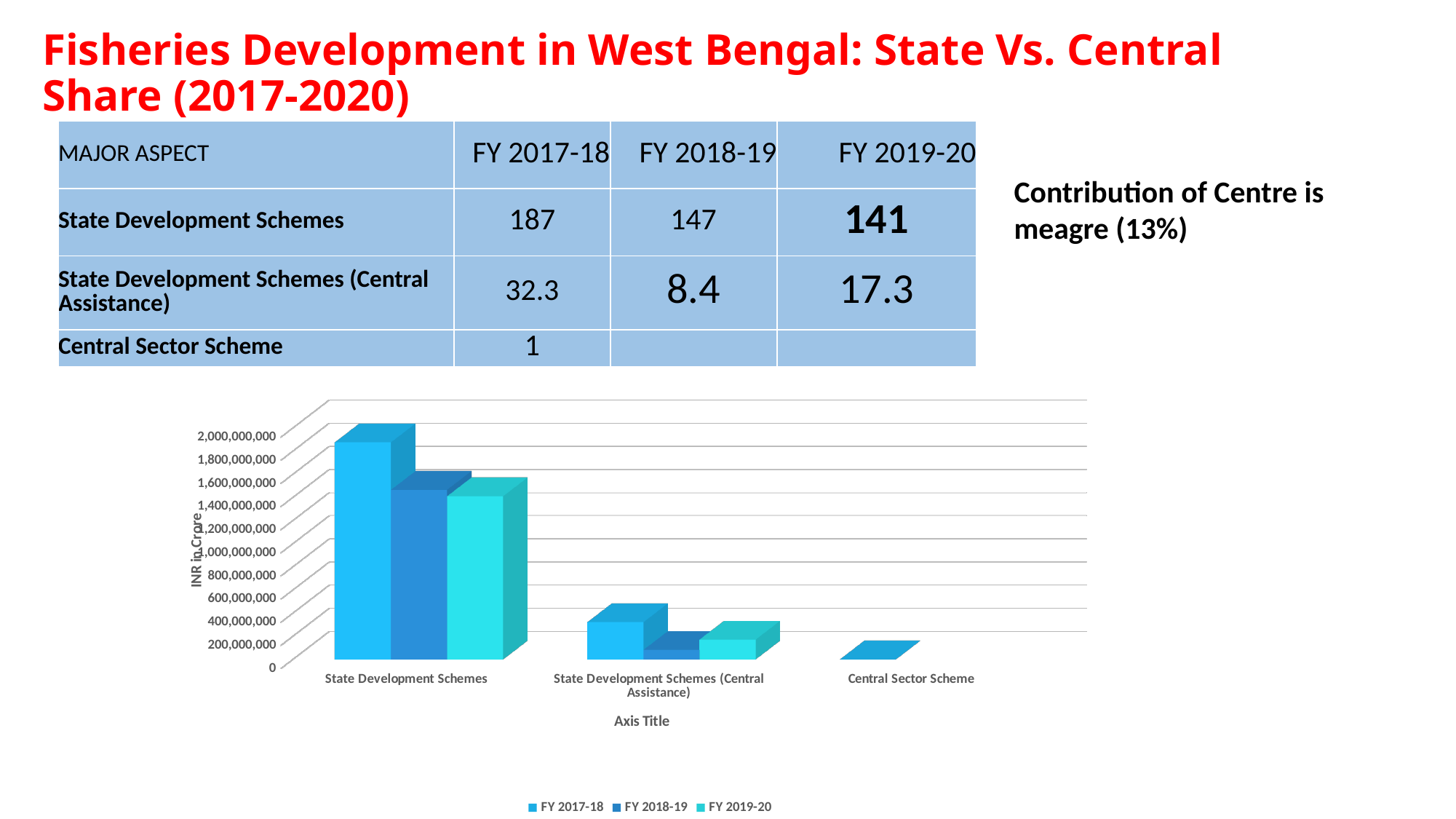
How many series does the chart's legend list? 3 Which series has the tallest bar for State Development Schemes in the chart? FY 2017-18 How many categories are shown on the chart's x axis? 3 What kind of chart is shown on the slide? bar chart In the chart, is the FY 2018-19 bar for State Development Schemes (Central Assistance) greater or less than 200,000,000? less In the chart, do the State Development Schemes bars rise or fall from FY 2017-18 to FY 2019-20? fall In the chart, is the FY 2017-18 bar for State Development Schemes greater or less than 1,600,000,000? greater In the chart, is the FY 2018-19 bar for State Development Schemes greater or less than 1,600,000,000? less What is the title of the chart's vertical axis? INR in Crore In the chart, which is larger for State Development Schemes (Central Assistance): the FY 2018-19 bar or the FY 2019-20 bar? FY 2019-20 Which series has the shortest bar for State Development Schemes (Central Assistance) in the chart? FY 2018-19